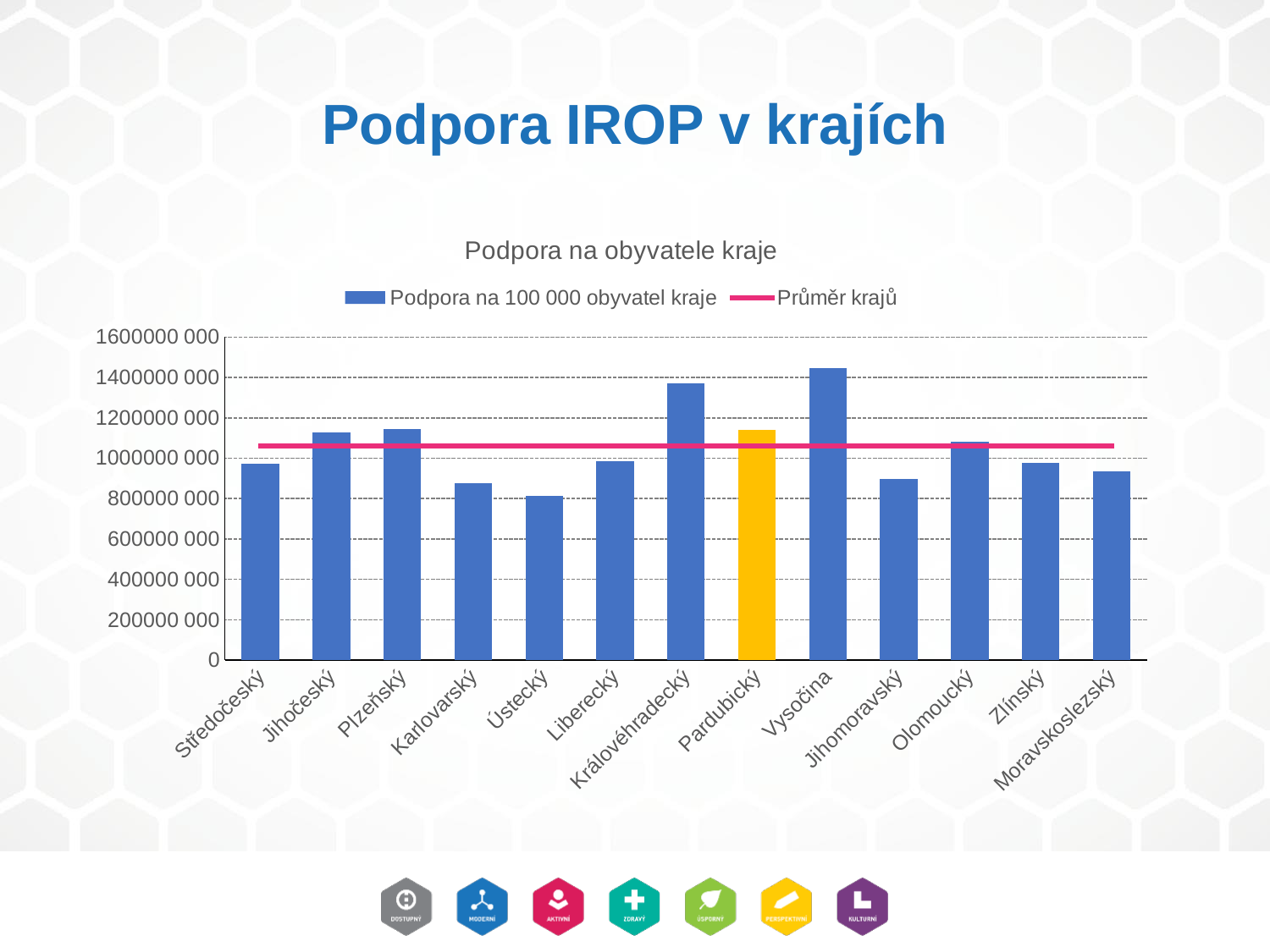
How many series does the chart legend list? 2 Which has a larger value, Středočeský or Jihočeský? Jihočeský Which region's bar is highlighted in a different colour (yellow) from the other bars? Pardubický How many regions (categories) are shown on the x axis of the chart? 13 Is the value for Ústecký greater or less than 1000000 000? less Which region has the lowest value for Podpora na 100 000 obyvatel kraje? Ústecký Which region has the highest value for Podpora na 100 000 obyvatel kraje? Vysočina Is the value for Vysočina greater or less than 1200000 000? greater What kind of chart is shown on the slide? combination bar and line chart Is the value for Jihomoravský greater or less than 1000000 000? less Which has a larger value, Vysočina or Královéhradecký? Vysočina